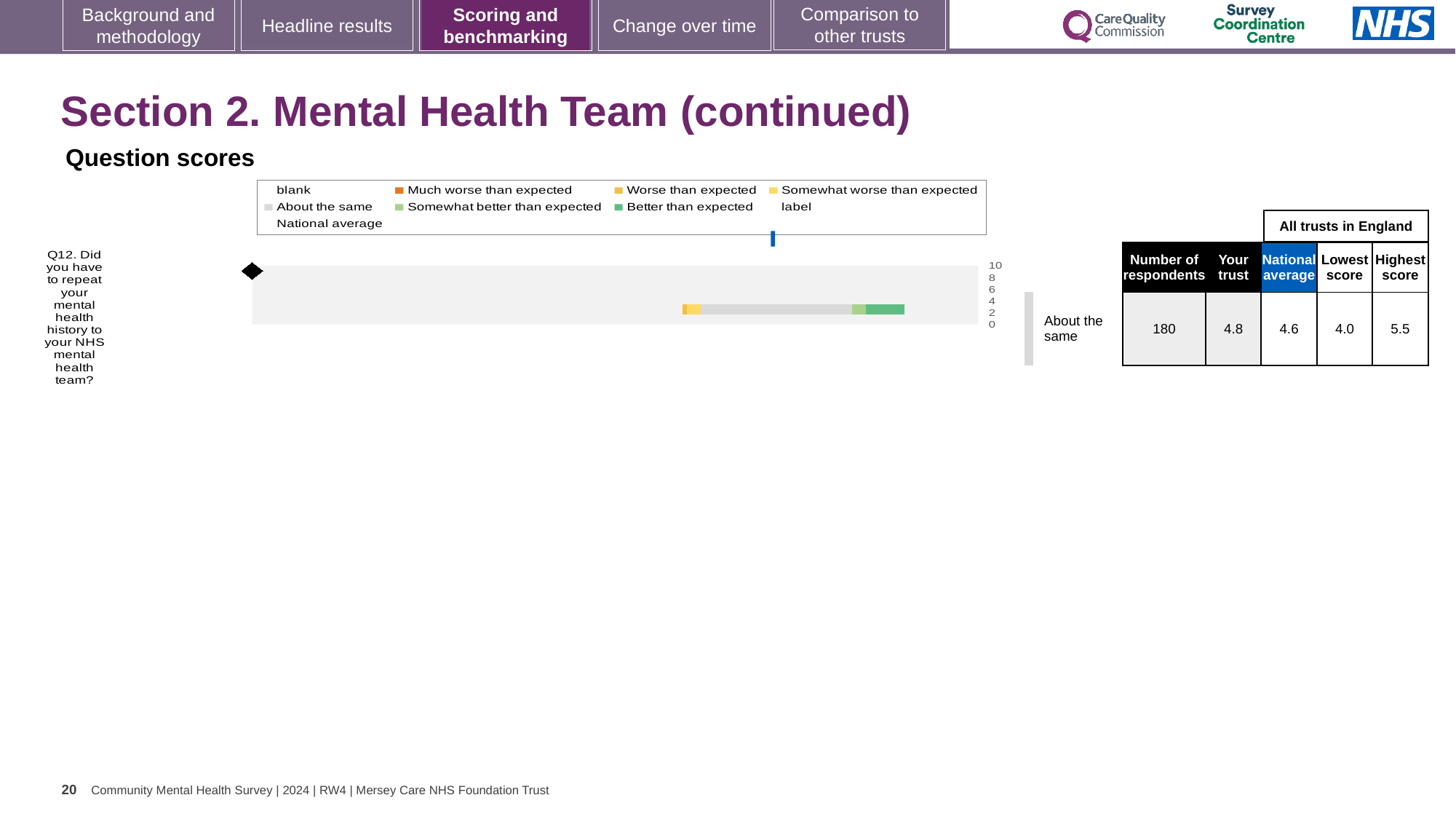
Is the 'Your trust' score for Q12 higher or lower than the national average? higher How many questions are plotted in the chart? 1 What is the highest score among all trusts in England for Q12? 5.5 What benchmark category is shown next to the bar for Q12? About the same What kind of chart is shown under 'Question scores'? bar chart What is the highest value shown on the chart's axis? 10 What is the 'Your trust' score for Q12? 4.8 What is the difference between the highest score and the lowest score for Q12? 1.5 What is the lowest score among all trusts in England for Q12? 4.0 How many respondents answered Q12? 180 Which question is plotted in the chart? Q12. Did you have to repeat your mental health history to your NHS mental health team? What is the national average score for Q12? 4.6